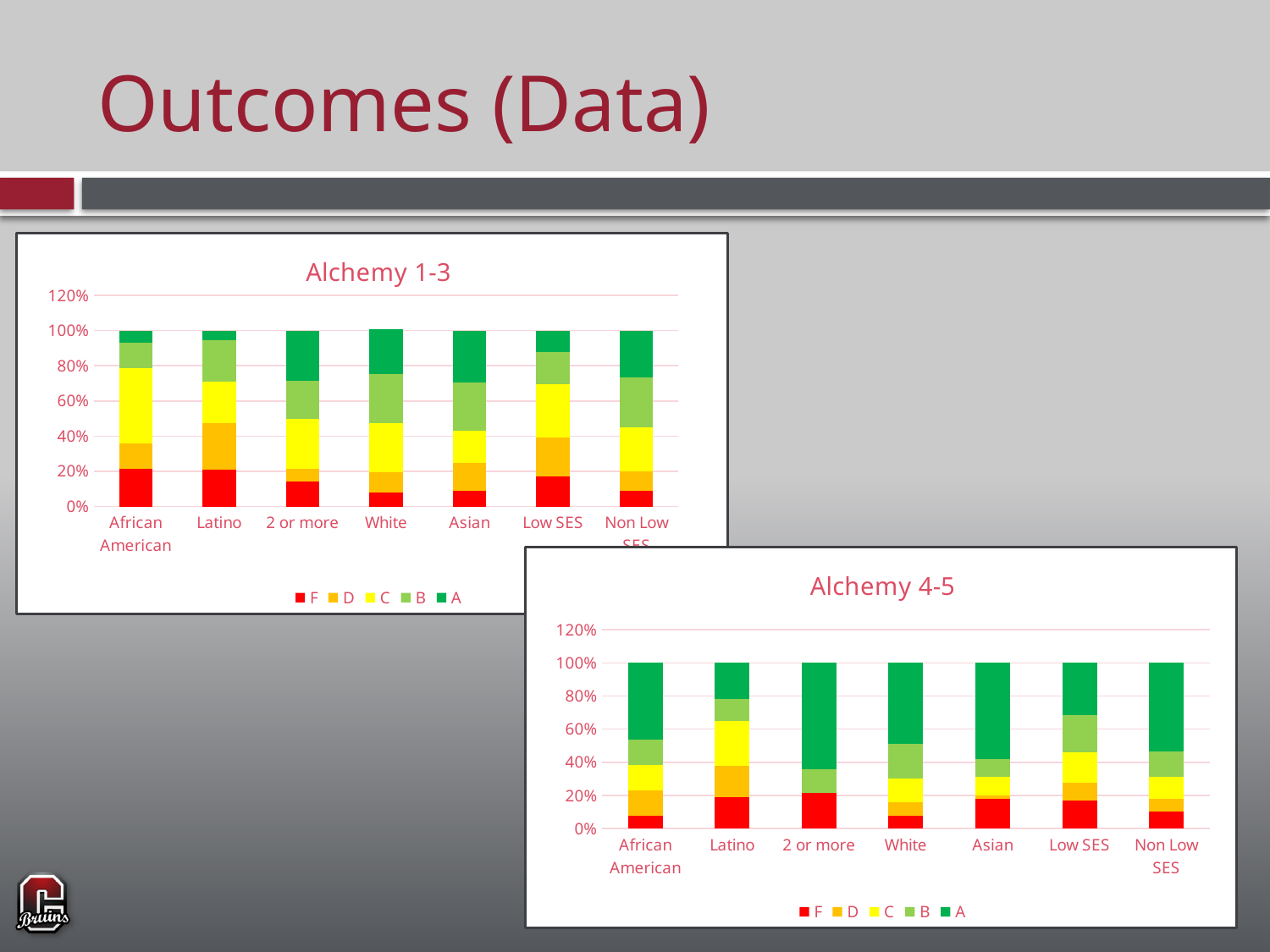
In the Alchemy 1-3 chart, which has the larger F value, African American or White? African American What is the title of the chart in the upper left of the slide? Alchemy 1-3 What are the legend entries of the Alchemy 4-5 chart? F, D, C, B, A In the Alchemy 4-5 chart, which category has the smallest A segment? Latino What kind of chart is the Alchemy 1-3 chart? Stacked bar chart How many categories are shown on the x axis of the Alchemy 4-5 chart? 7 In the Alchemy 4-5 chart, is the F value for African American greater or less than 20%? less In the Alchemy 4-5 chart, which has the larger F value, 2 or more or White? 2 or more In the Alchemy 1-3 chart, what is the total height of the stacked bar for White? 100% In the Alchemy 1-3 chart, is the F value for White greater or less than 20%? less How many series does the legend of the Alchemy 1-3 chart list? 5 In the Alchemy 1-3 chart, is the F value for 2 or more greater or less than 20%? less